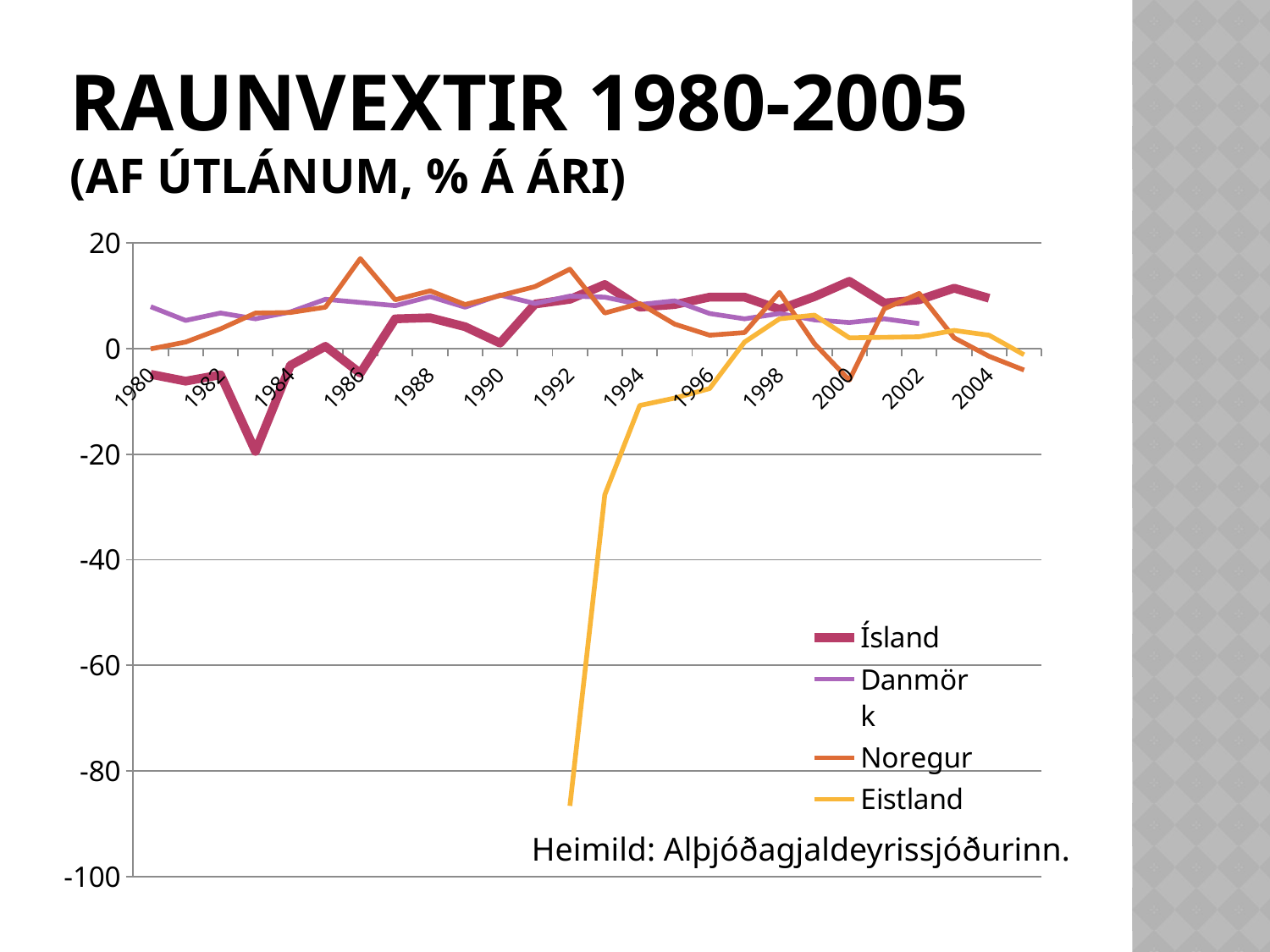
Which series reaches the lowest value anywhere on the chart? Eistland Is the value for Noregur in 2000 greater or less than 0? less Which series are listed in the legend? Ísland, Danmörk, Noregur, Eistland What kind of chart is shown on the slide? line chart Is the value for Eistland in 1992 greater or less than -80? less How many series does the legend list? 4 Is the value for Noregur in 1986 greater or less than 10? greater In 1983, which series has the higher value, Ísland or Danmörk? Danmörk Does the Eistland line rise or fall between 1992 and 1998? rise Which series has the highest value in 1986? Noregur What is the title of the chart? Raunvextir 1980-2005 (af útlánum, % á ári)